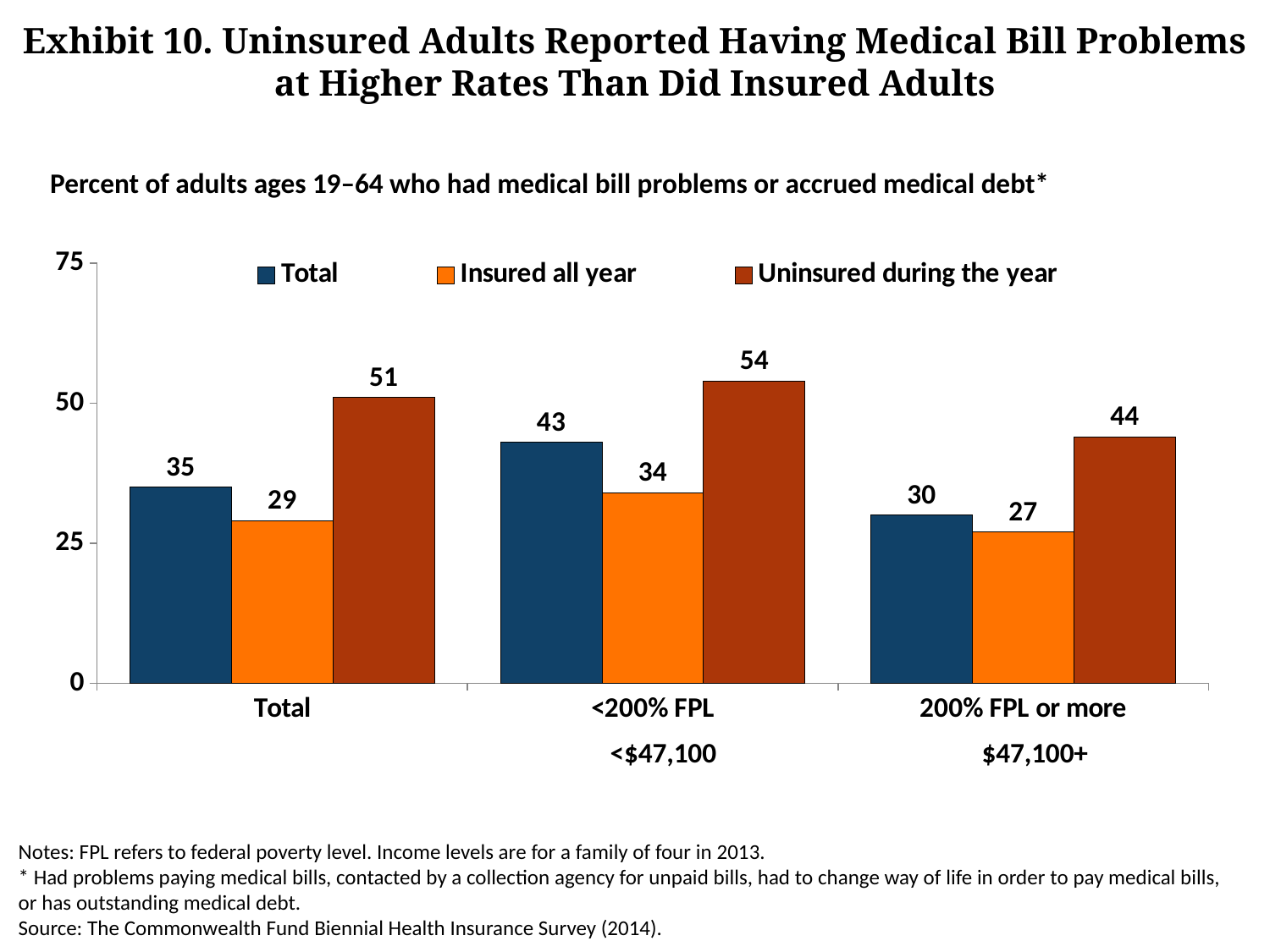
What kind of chart is shown on the slide? bar chart Which category has the lowest value for Insured all year? 200% FPL or more What is the value for Insured all year in the Total category? 29 Is the value for Total in the <200% FPL category greater or less than 50? less Which is larger in the 200% FPL or more category: Total or Uninsured during the year? Uninsured during the year What is the value for Uninsured during the year in the <200% FPL category? 54 How many categories are shown on the x axis? 3 What colour are the bars for Insured all year? orange How many series does the legend list? 3 What is the value for Total in the 200% FPL or more category? 30 What is the difference between Uninsured during the year and Insured all year in the Total category? 22 Which category has the highest value for Uninsured during the year? <200% FPL